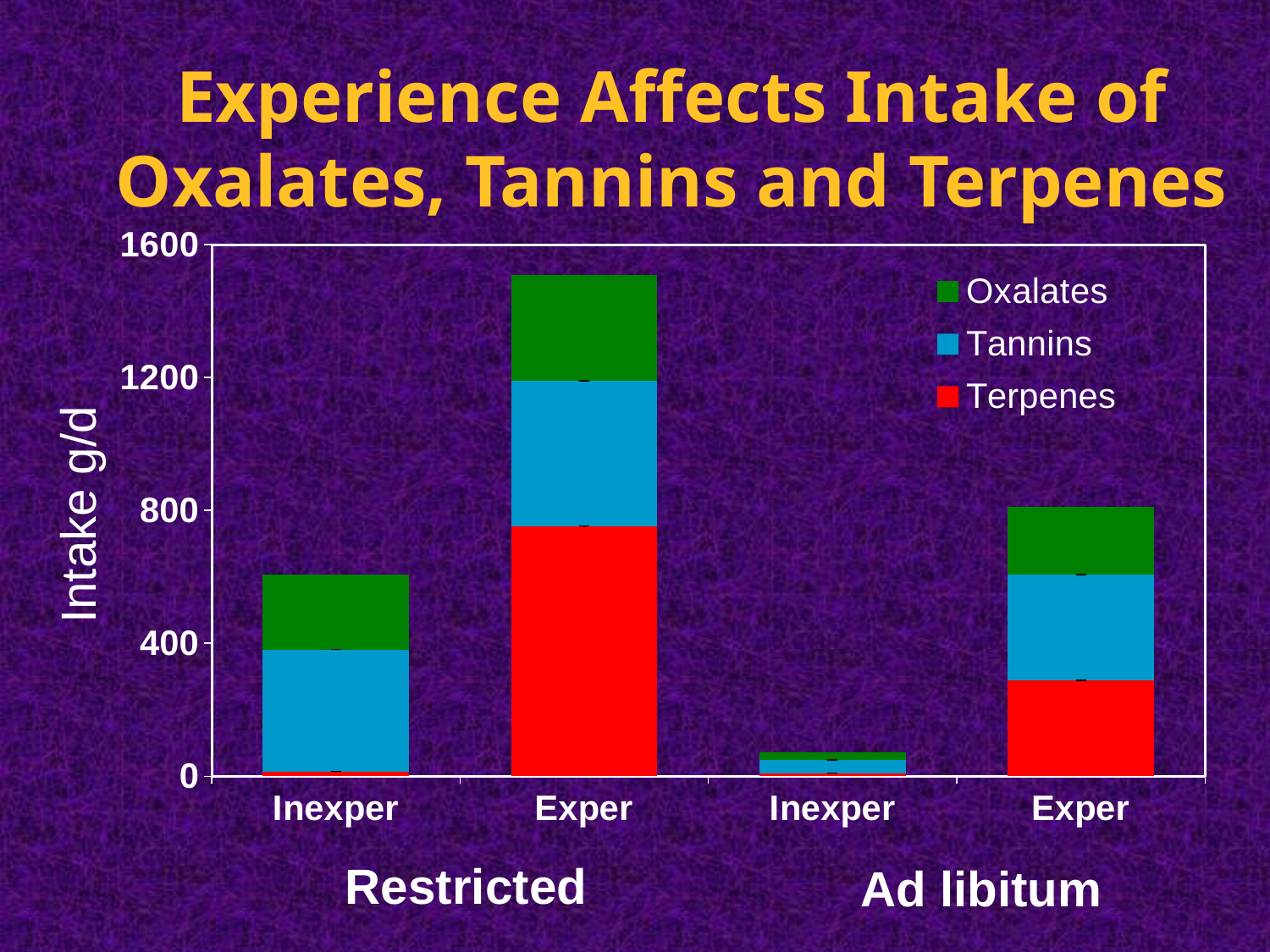
How many series does the legend list? 3 Which has the larger total intake: Exper under Restricted or Exper under Ad libitum? Exper under Restricted How many bars are plotted in the chart? 4 Which bar has the lowest total intake? Inexper (Ad libitum) What kind of chart is shown on the slide? Stacked bar chart Is the total intake for Inexper under Restricted greater or less than 400? greater Is the total intake for Exper under Restricted greater or less than 1200? greater Which bar has the highest total intake? Exper (Restricted) What is the label on the y axis? Intake g/d Is the total intake for Inexper under Ad libitum greater or less than 400? less Which colour represents Tannins in the legend? Blue